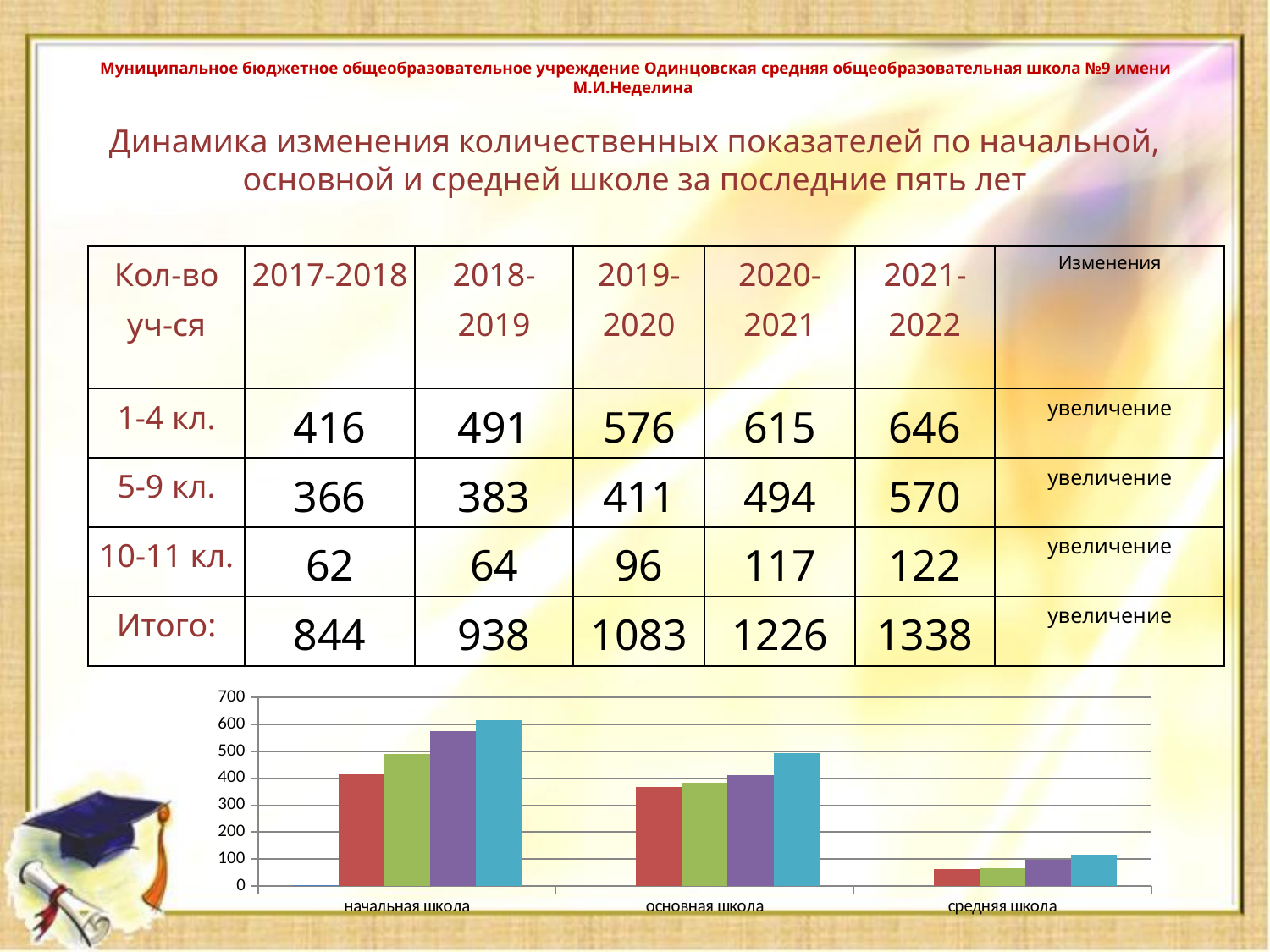
What is the label of the middle category on the x axis of the bar chart? основная школа What kind of chart is shown at the bottom of the slide? bar chart On the bar chart, is the tallest bar for основная школа greater or less than 400? greater On the bar chart, is the red bar for средняя школа greater or less than 100? less Which category on the bar chart has the tallest bars? начальная школа On the bar chart, are the bars for начальная школа taller or shorter than the bars for средняя школа? taller Which category on the bar chart has the shortest bars? средняя школа On the bar chart, is the red bar for основная школа greater or less than 400? less How many categories are shown on the x axis of the bar chart? 3 What is the highest tick value shown on the y axis of the bar chart? 700 Within each category on the bar chart, do the bars rise or fall from left to right? rise